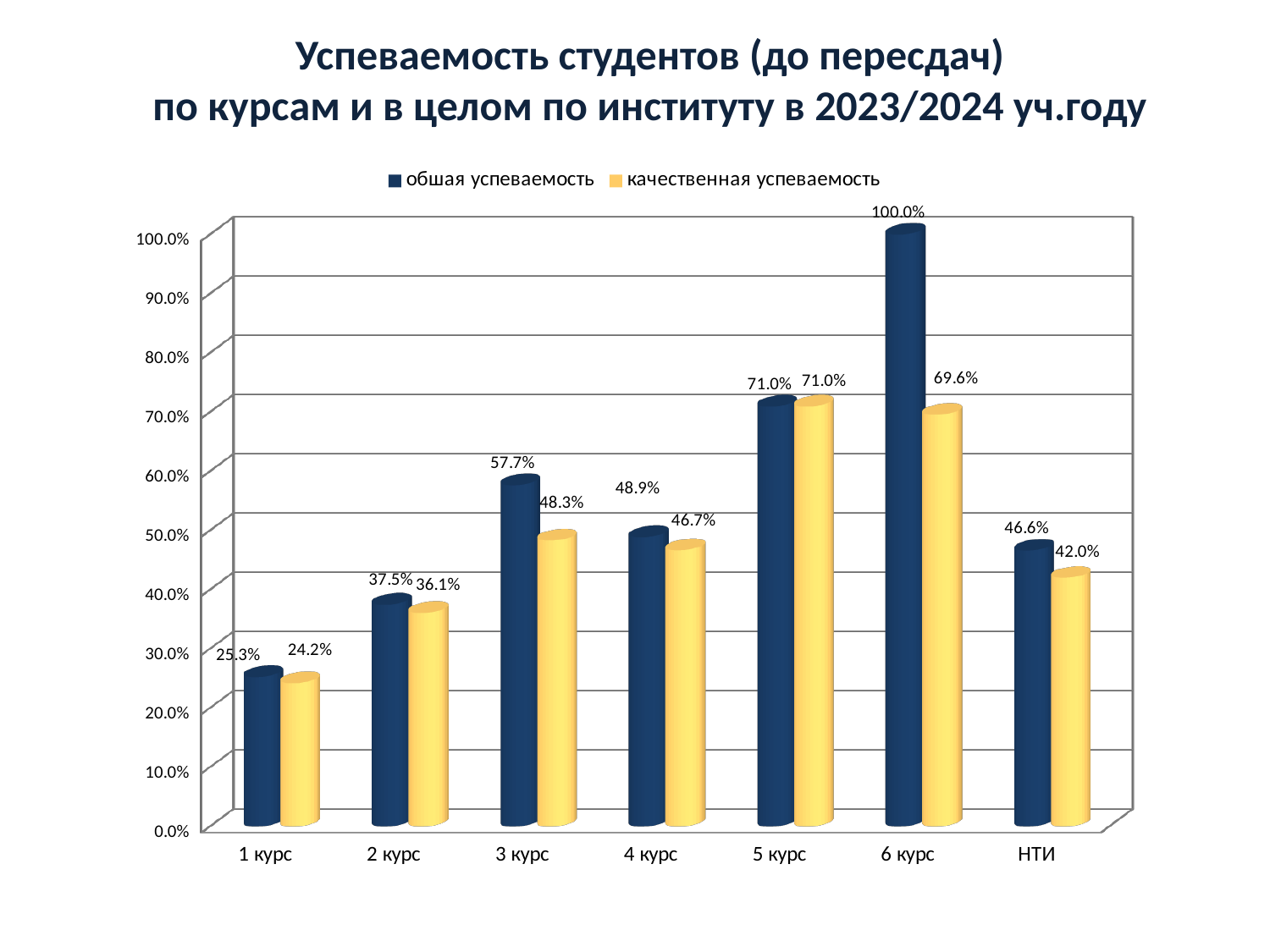
What is the общая успеваемость value for НТИ? 46.6% What kind of chart is shown on the slide? bar chart Which category has the lowest качественная успеваемость? 1 курс Which series is shown in yellow? качественная успеваемость What is the качественная успеваемость value for 1 курс? 24.2% How many categories are shown on the x axis? 7 What is the качественная успеваемость value for 6 курс? 69.6% What is the общая успеваемость value for 3 курс? 57.7% Which category has the highest общая успеваемость? 6 курс How many series does the legend list? 2 Which is larger: общая успеваемость for 3 курс or общая успеваемость for 4 курс? 3 курс What is the difference between общая успеваемость and качественная успеваемость for 6 курс? 30.4%